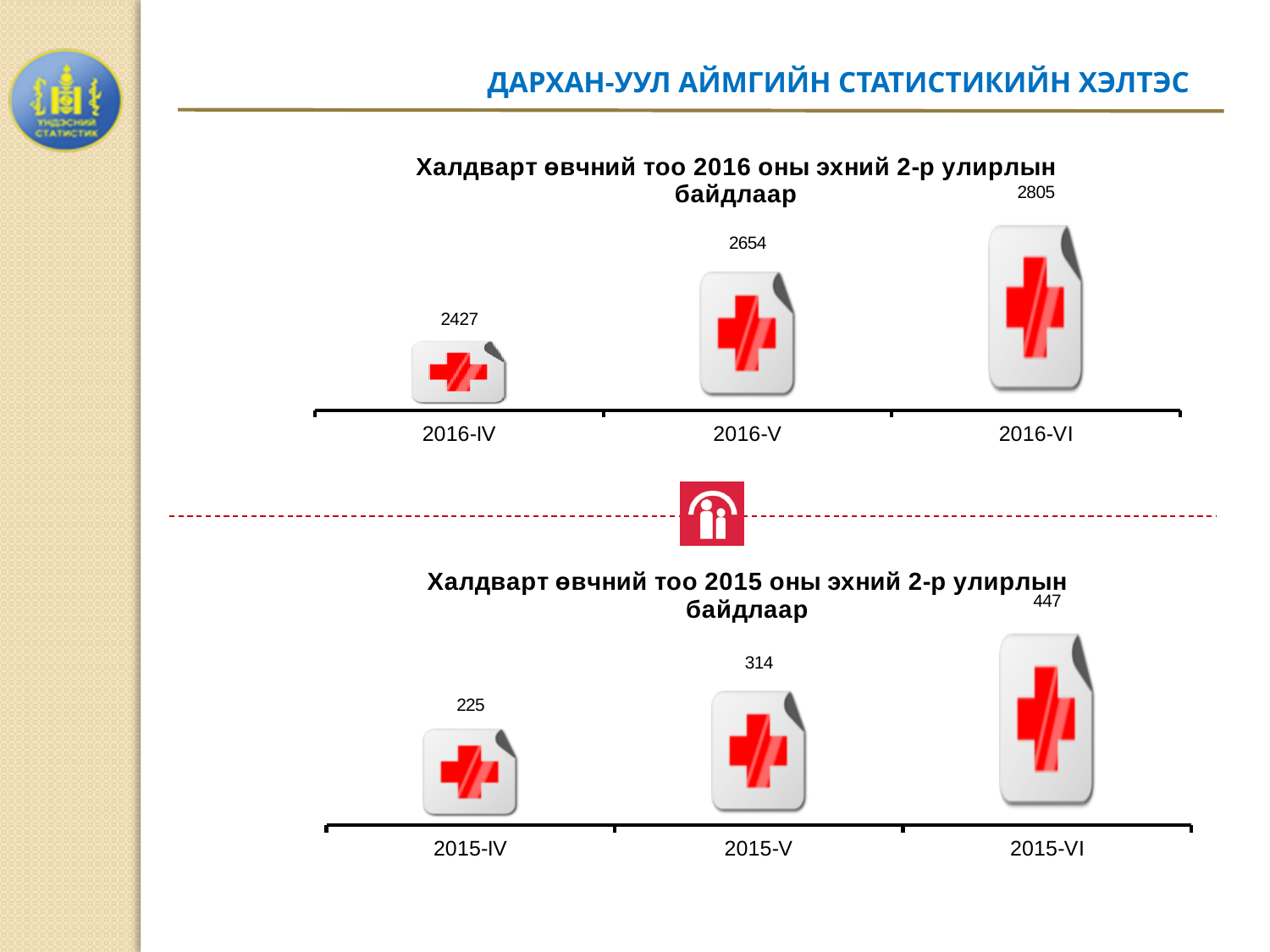
In the top chart (2016), what is the value for 2016-IV? 2427 In the bottom chart (2015), what is the difference between the values for 2015-V and 2015-IV? 89 In the bottom chart (2015), what is the value for 2015-V? 314 In the top chart (2016), what is the difference between the values for 2016-VI and 2016-IV? 378 In the bottom chart (2015), what is the value for 2015-VI? 447 In the bottom chart (2015), which month has the lowest value? 2015-IV In the top chart (2016), what is the value for 2016-V? 2654 In the bottom chart (2015), which is larger, the value for 2015-VI or 2015-V? 2015-VI What is the title of the bottom chart? Халдварт өвчний тоо 2015 оны эхний 2-р улирлын байдлаар In the top chart (2016), which month has the highest value? 2016-VI In the top chart (2016), how many categories are shown on the x axis? 3 In the top chart (2016), do the values rise or fall from 2016-IV to 2016-VI? rise